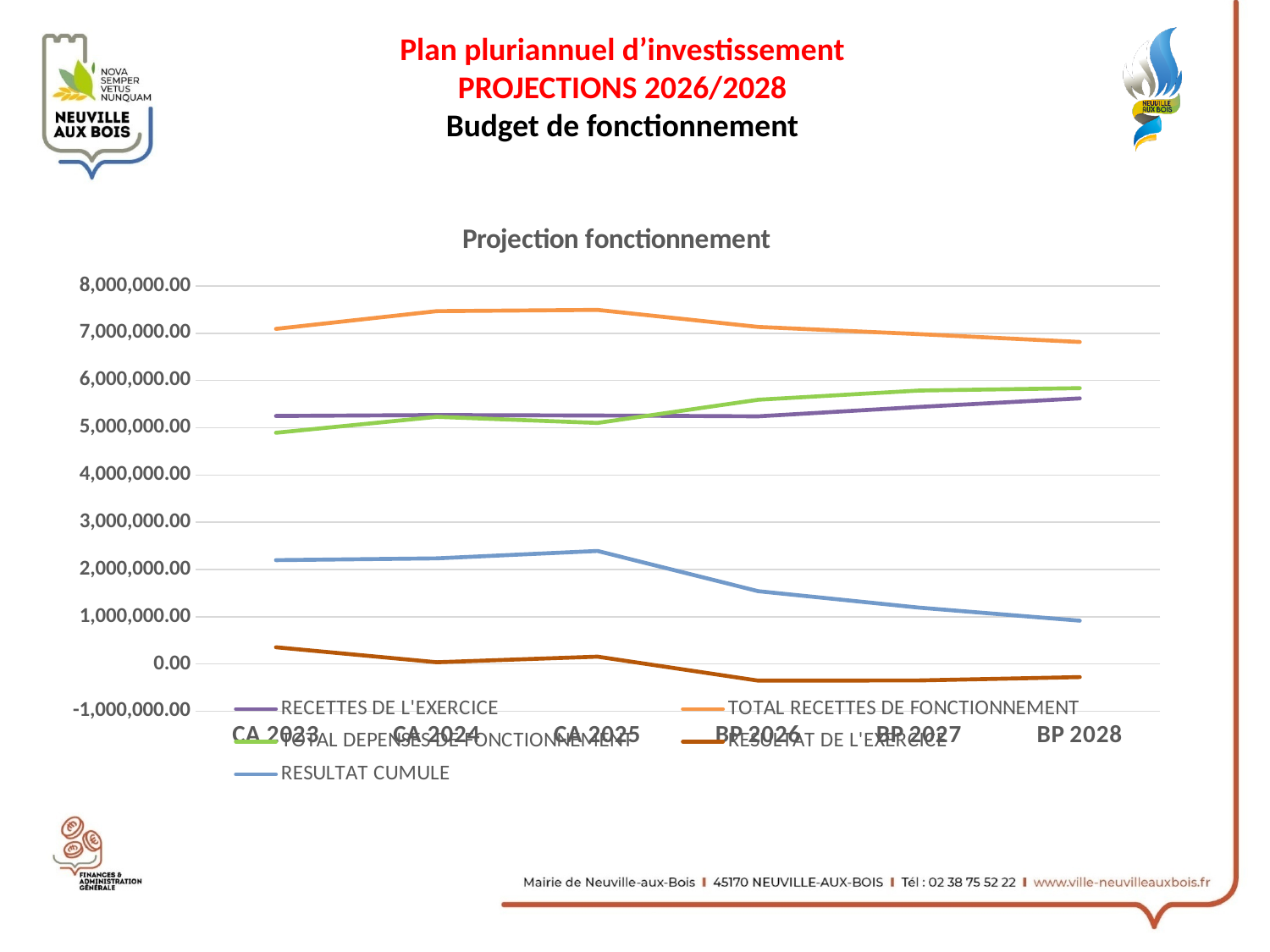
Which series has the highest value at CA 2023? TOTAL RECETTES DE FONCTIONNEMENT Does RESULTAT CUMULE rise or fall from CA 2025 to BP 2028? fall In which category does RESULTAT CUMULE reach its highest value? CA 2025 Is the value of TOTAL RECETTES DE FONCTIONNEMENT at BP 2028 greater or less than 7,000,000.00? less Is the value of RESULTAT CUMULE at CA 2025 greater or less than 2,000,000.00? greater Which is larger, RESULTAT CUMULE at CA 2023 or RESULTAT CUMULE at BP 2028? CA 2023 What is the title of the chart? Projection fonctionnement Which series has the lowest value at BP 2026? RESULTAT DE L'EXERCICE In which category is TOTAL RECETTES DE FONCTIONNEMENT lowest? BP 2028 How many categories are shown along the x axis of the chart? 6 What kind of chart is shown on the slide? line chart How many series does the chart legend list? 5